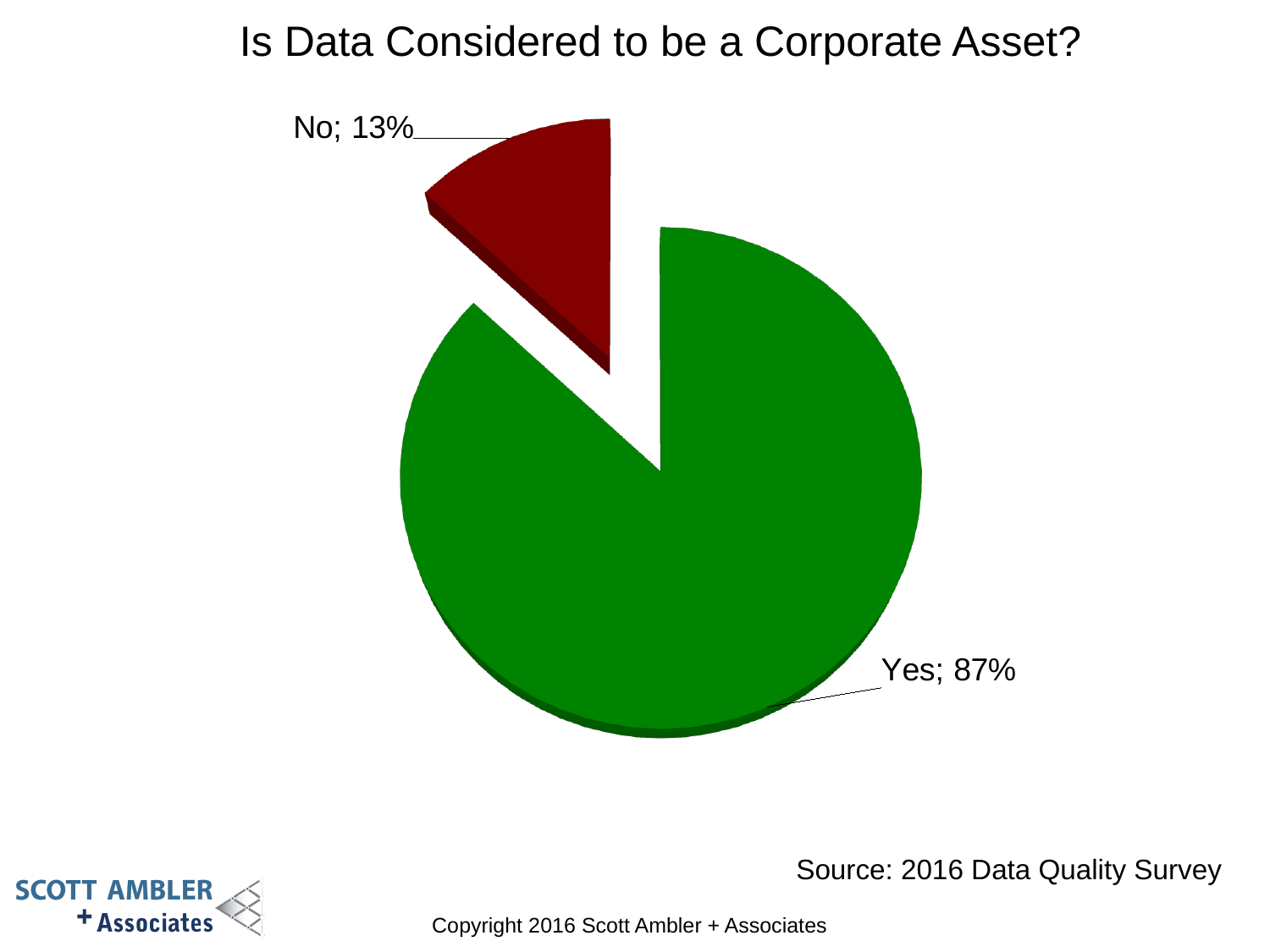
What is the difference in percentage points between the Yes and No slices? 74 What kind of chart is shown on the slide? Pie chart What percentage of respondents answered Yes? 87% Which slice is the smallest? No Which is larger, the Yes slice or the No slice? Yes What percentage of respondents answered No? 13% What is the title of the chart? Is Data Considered to be a Corporate Asset? How many slices does the pie chart have? 2 Which slice is the largest? Yes What share of the pie does the No slice represent? 13% What colour is the Yes slice? Green